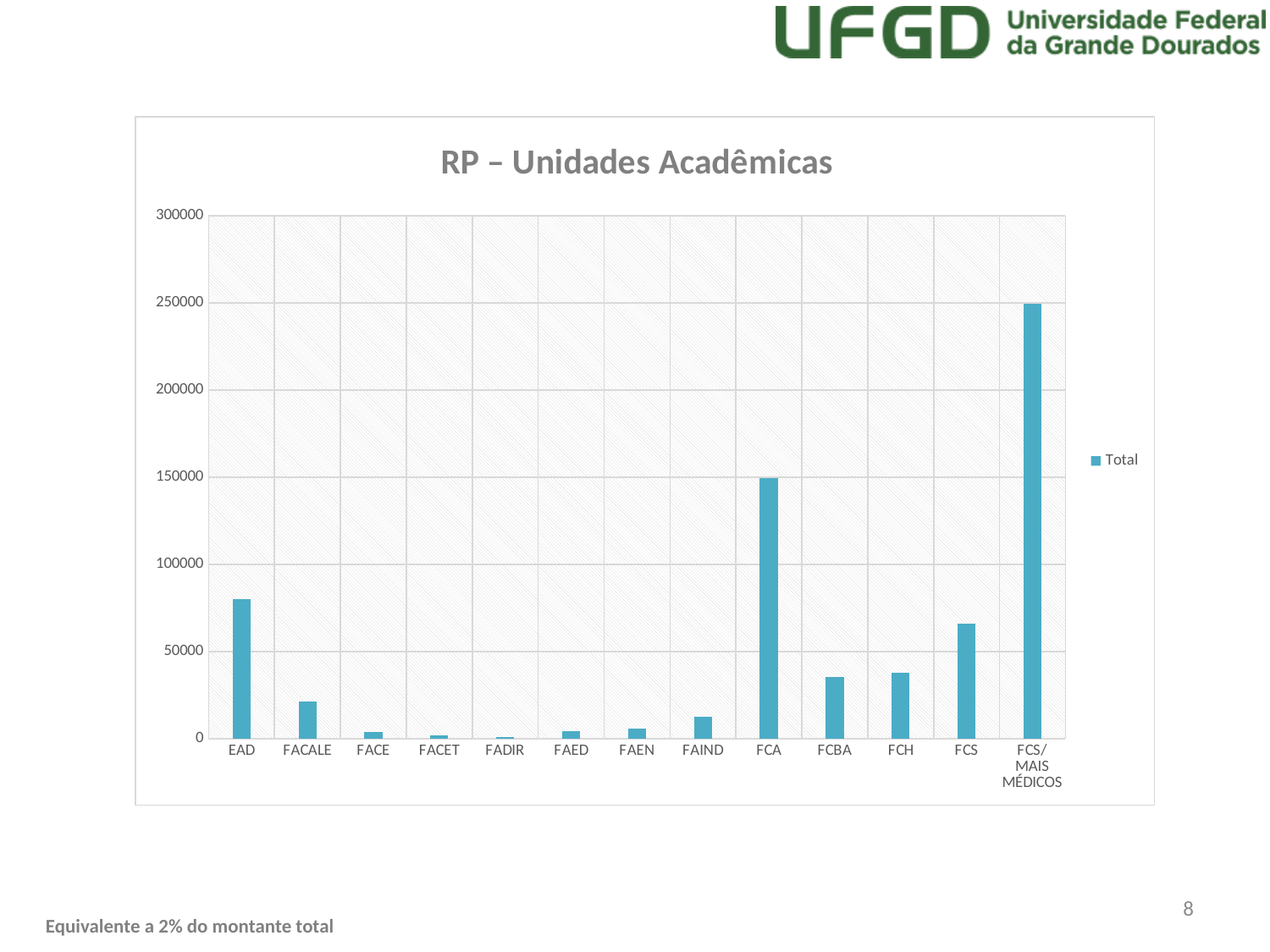
What is the title of the chart? RP – Unidades Acadêmicas Which academic unit has the highest value? FCS/MAIS MÉDICOS Is the value for EAD greater or less than 50000? greater What is the name of the series shown in the legend? Total Is the value for FCBA greater or less than 50000? less Is the value for FCA greater or less than 100000? greater What type of chart is shown on the slide? bar chart How many academic units (categories) are shown on the x axis? 13 How many series does the legend list? 1 Which has the larger value, EAD or FCBA? EAD Which has the larger value, FCA or FCS? FCA